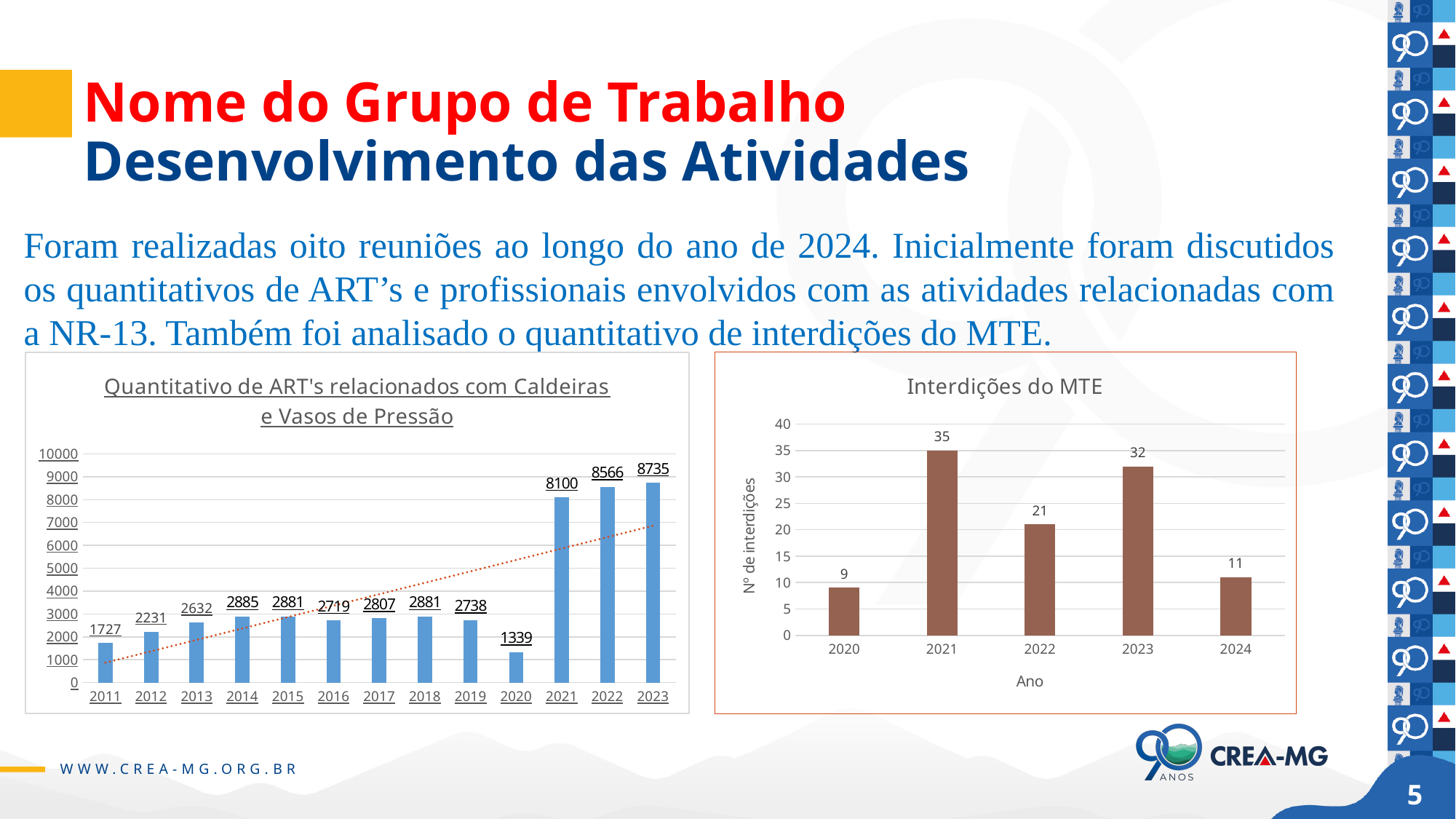
In the 'Interdições do MTE' chart, which year has the highest number of interdictions? 2021 In the 'Quantitativo de ART's relacionados com Caldeiras e Vasos de Pressão' chart, what is the difference between the values for 2023 and 2022? 169 What is the label of the y axis in the 'Interdições do MTE' chart? Nº de interdições In the 'Interdições do MTE' chart, what is the value for 2022? 21 In the 'Quantitativo de ART's relacionados com Caldeiras e Vasos de Pressão' chart, what is the value for 2021? 8100 What kind of chart is the 'Interdições do MTE' chart? bar chart In the 'Interdições do MTE' chart, what is the difference between the values for 2021 and 2023? 3 In the 'Quantitativo de ART's relacionados com Caldeiras e Vasos de Pressão' chart, how many years are shown on the x axis? 13 In the 'Quantitativo de ART's relacionados com Caldeiras e Vasos de Pressão' chart, which year has the highest value? 2023 In the 'Quantitativo de ART's relacionados com Caldeiras e Vasos de Pressão' chart, is the value for 2012 greater or less than 2000? greater In the 'Quantitativo de ART's relacionados com Caldeiras e Vasos de Pressão' chart, which year has the lowest value? 2020 In the 'Interdições do MTE' chart, which is larger, the value for 2020 or the value for 2024? 2024